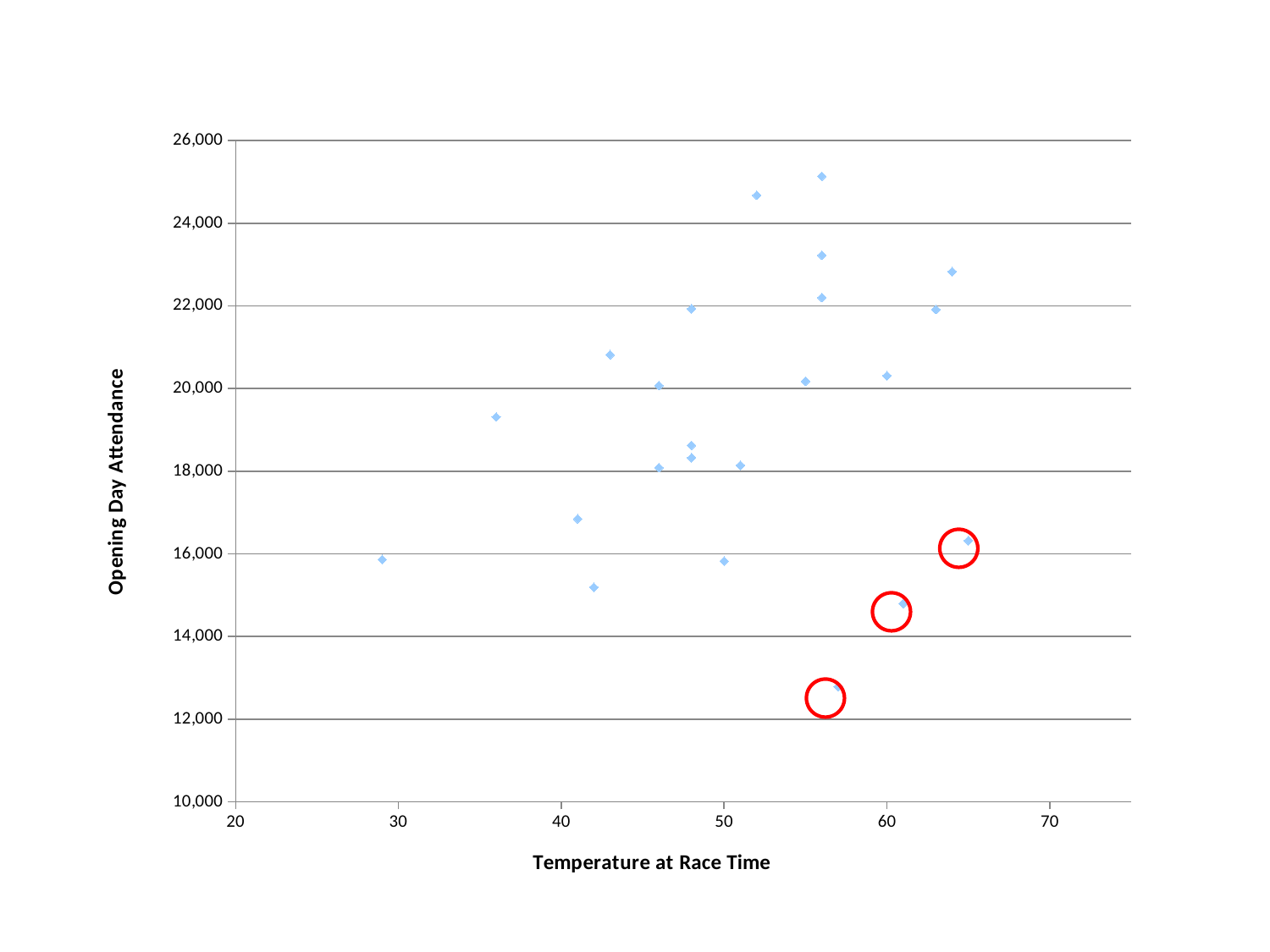
Is the attendance for the point at a temperature of about 29 greater or less than 18,000? less Is the highest Opening Day Attendance value plotted greater or less than 24,000? greater What is the label of the horizontal axis? Temperature at Race Time Is the attendance for the point at a temperature of about 43 greater or less than 20,000? greater What kind of chart is shown on the slide? Scatter plot Which has the higher attendance: the point at a temperature of about 36 or the point at a temperature of about 42? The point at about 36 How many data points are circled in red? 3 What is the label of the vertical axis? Opening Day Attendance